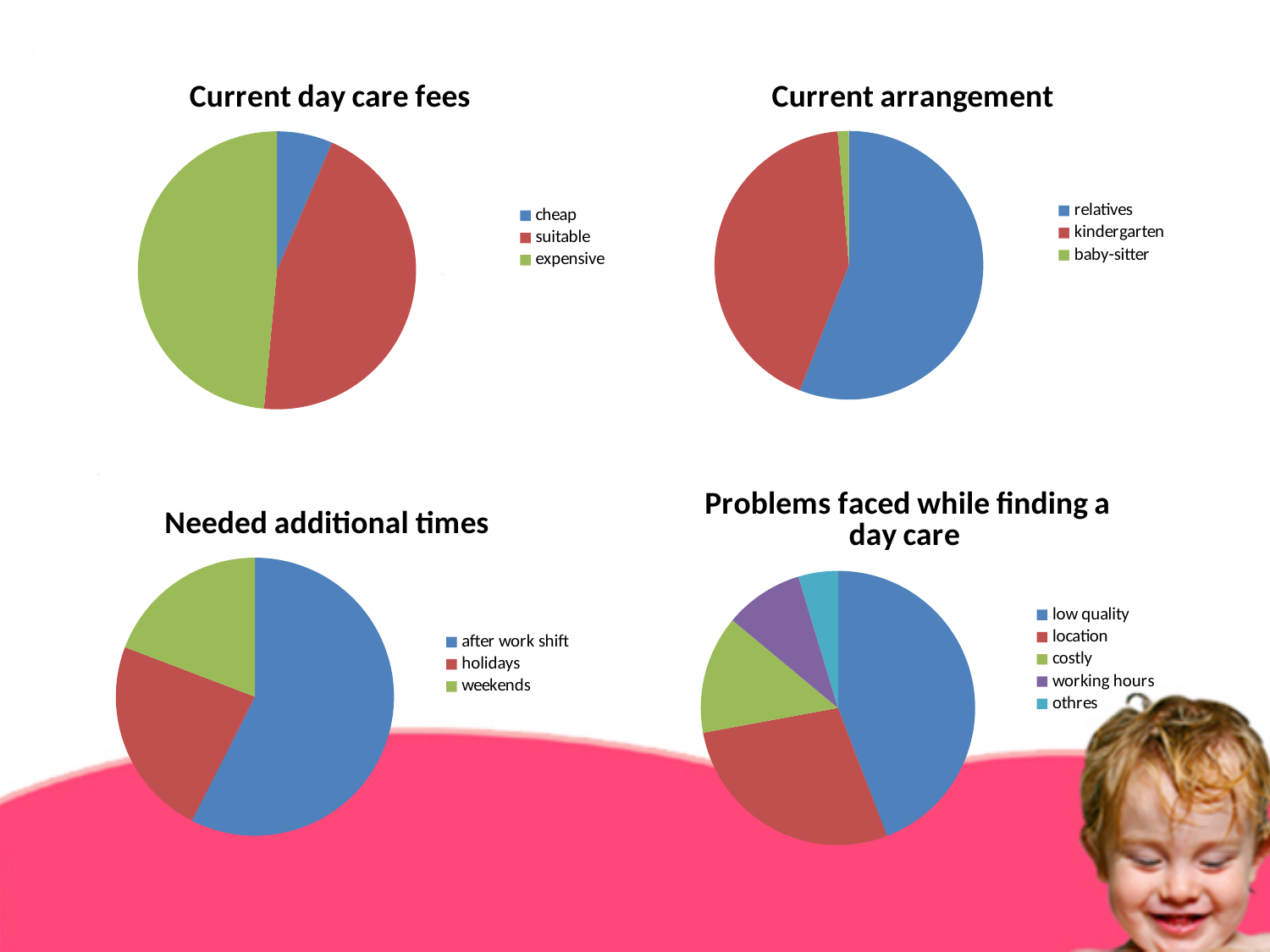
In the "Problems faced while finding a day care" chart, which category has the smallest slice? othres In the "Current day care fees" chart, which category has the smallest slice? cheap In the "Current arrangement" chart, which category has the largest slice? relatives How many categories does the "Current day care fees" chart show? 3 In the "Current arrangement" chart, which category has the smallest slice? baby-sitter In the "Problems faced while finding a day care" chart, what colour is the "working hours" slice? purple In the "Current arrangement" chart, which is larger: kindergarten or baby-sitter? kindergarten In the "Needed additional times" chart, which is larger: after work shift or weekends? after work shift What kind of chart is the "Current day care fees" chart? pie chart In the "Needed additional times" chart, which category has the largest slice? after work shift In the "Problems faced while finding a day care" chart, which category has the largest slice? low quality How many categories does the "Problems faced while finding a day care" chart show? 5